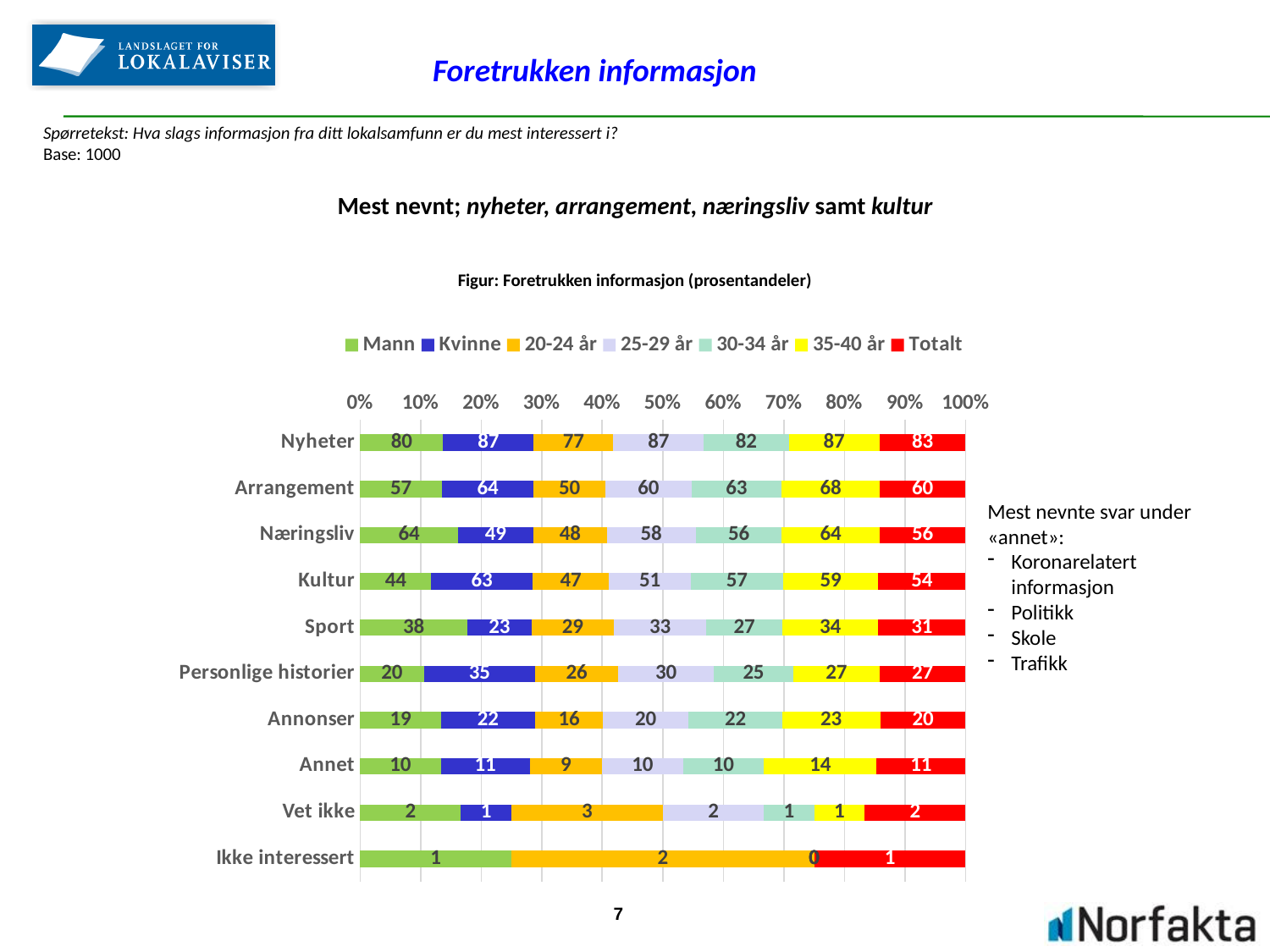
What is the 35-40 år value for Annet? 14 What is the Totalt value for Nyheter? 83 What is the Kvinne value for Kultur? 63 Which category has the highest Totalt value? Nyheter For Kultur, which is larger: the Mann value or the Kvinne value? Kvinne What is the Mann value for Næringsliv? 64 What is the 20-24 år value for Sport? 29 What is the difference between the Kvinne and Mann values for Nyheter? 7 How many categories are shown on the vertical axis of the chart? 10 How many series does the legend list? 7 What kind of chart is shown on the slide? Stacked bar chart What is the difference between the Mann and Kvinne values for Sport? 15